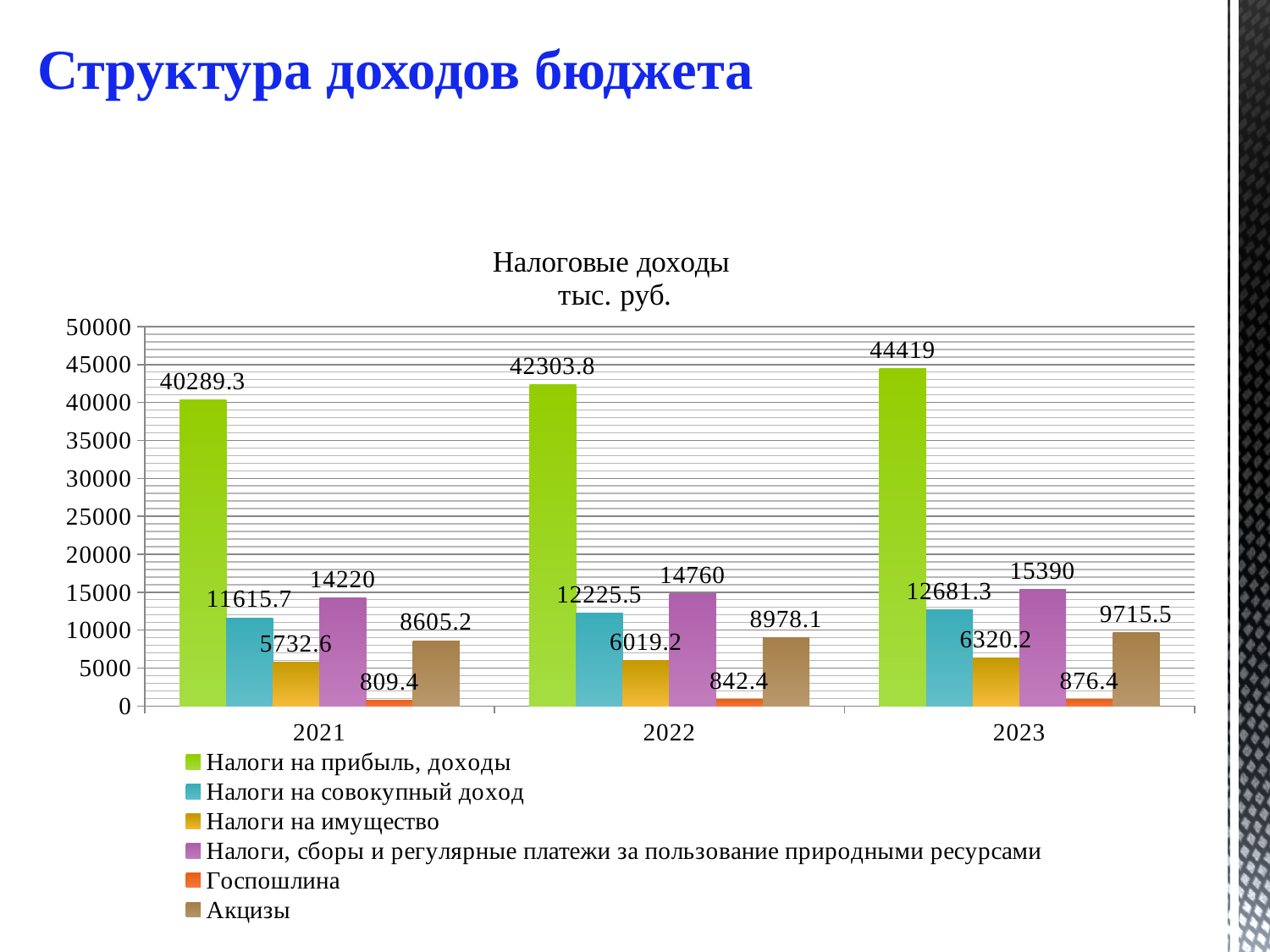
Which series has the lowest value in 2023? Госпошлина What is the value for Акцизы in 2022? 8978.1 What is the value for Налоги на совокупный доход in 2022? 12225.5 How many years are shown on the x axis? 3 Which series has the highest value in 2021? Налоги на прибыль, доходы How many series does the legend list? 6 Which is larger: Налоги на имущество in 2021 or Акцизы in 2021? Акцизы in 2021 What is the value for Налоги на прибыль, доходы in 2023? 44419 What is the difference between Налоги на прибыль, доходы in 2023 and in 2022? 2115.2 What type of chart is shown on the slide? bar chart Do the values for Налоги, сборы и регулярные платежи за пользование природными ресурсами rise or fall from 2021 to 2023? rise What is the value for Госпошлина in 2021? 809.4